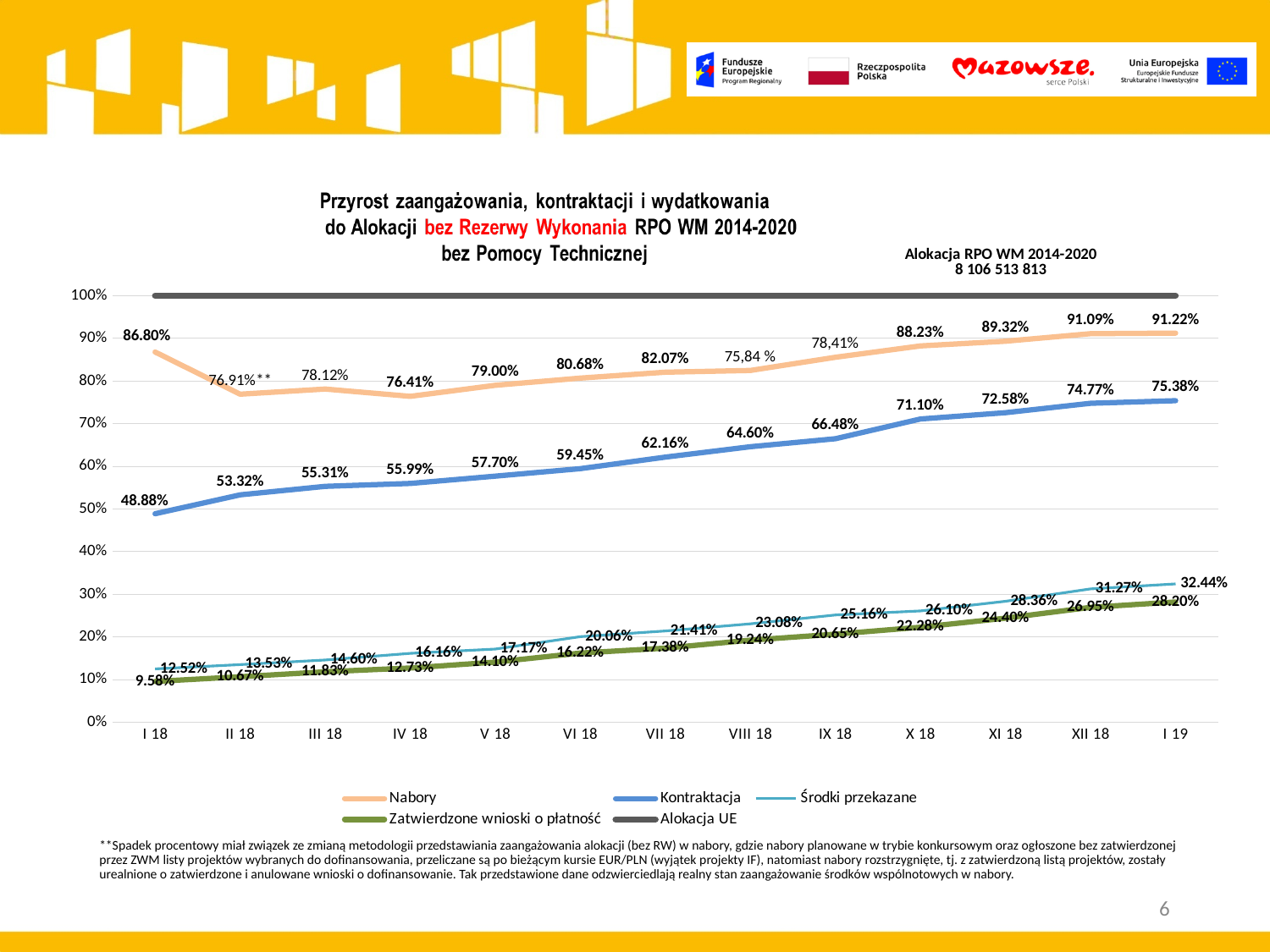
In which month is the Kontraktacja value highest? I 19 What is the value of Kontraktacja for I 19? 75.38% What is the difference between the Kontraktacja values for I 19 and I 18? 26.50% Does the Kontraktacja series rise or fall from I 18 to I 19? rise How many series does the legend list? 5 How many time points are shown on the x axis? 13 What is the value of Środki przekazane for XII 18? 31.27% What type of chart is shown on the slide? line chart What is the value of Nabory for I 18? 86.80% What is the value of Zatwierdzone wnioski o płatność for VI 18? 16.22% Which is larger for X 18: Środki przekazane or Zatwierdzone wnioski o płatność? Środki przekazane